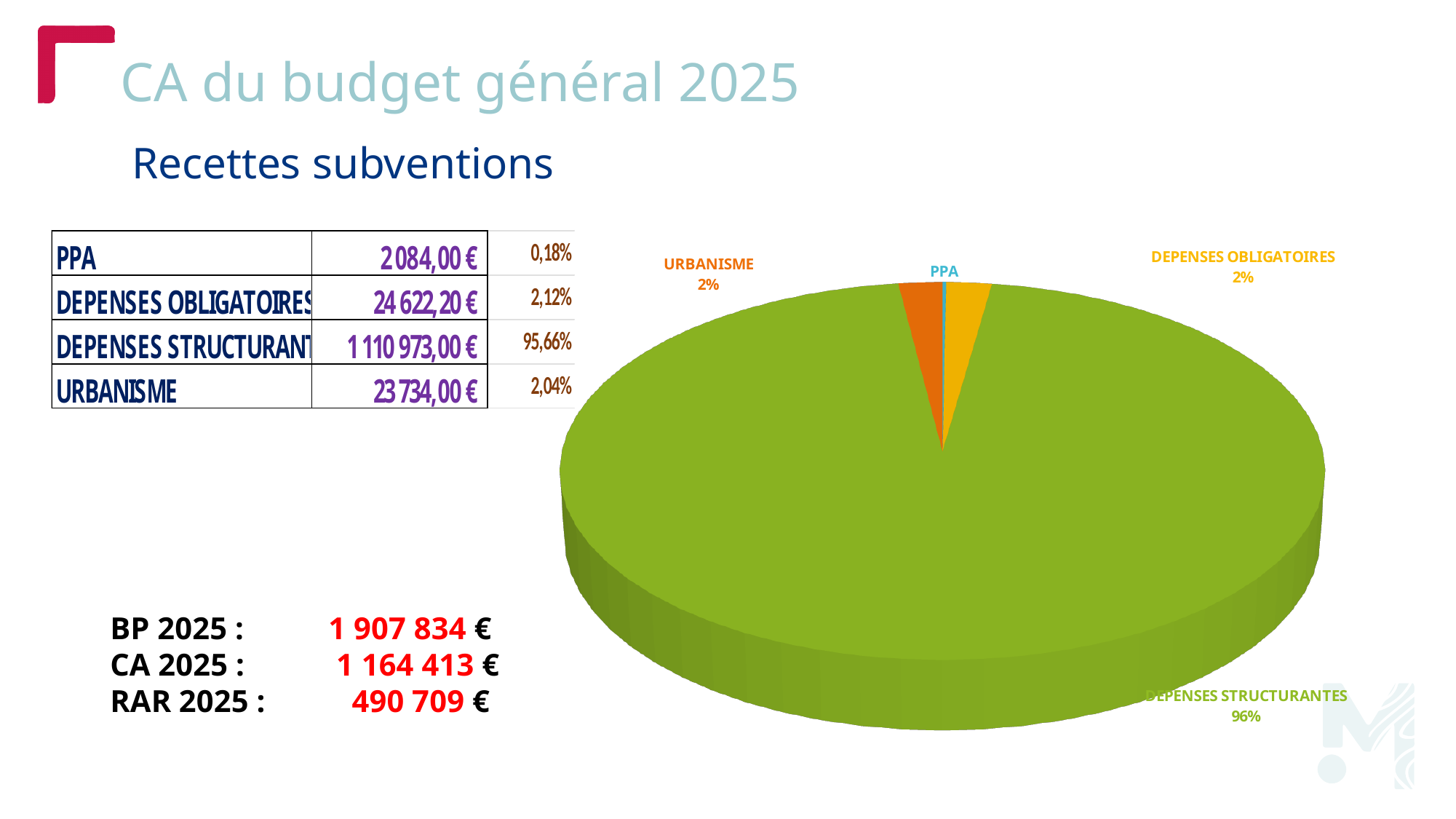
What colour is the URBANISME slice? orange Which slice is larger, PPA or DEPENSES OBLIGATOIRES? DEPENSES OBLIGATOIRES Which category has the smallest slice of the pie? PPA What share of the pie does URBANISME represent? 2% How many slices does the pie chart have? 4 What share of the pie does DEPENSES OBLIGATOIRES represent? 2% Which category has the largest slice of the pie? DEPENSES STRUCTURANTES What share of the pie does DEPENSES STRUCTURANTES represent? 96% According to the table next to the chart, what is the value for DEPENSES OBLIGATOIRES? 24 622,20 € What colour is the DEPENSES STRUCTURANTES slice? green What kind of chart is shown on the slide? pie chart Which slice is larger, DEPENSES STRUCTURANTES or URBANISME? DEPENSES STRUCTURANTES